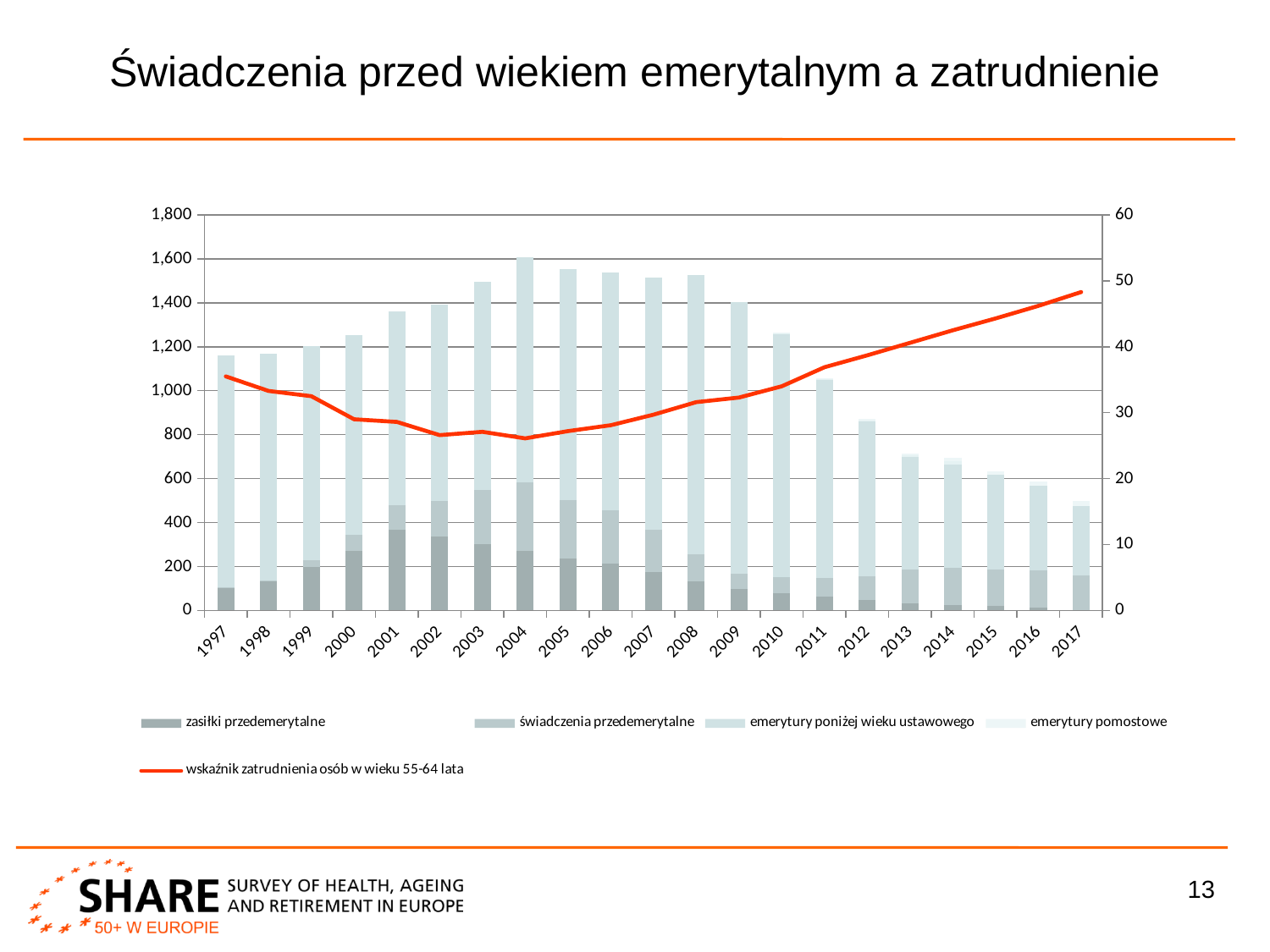
Which stacked bar is taller, 1997 or 2017? 1997 What kind of chart is shown on the slide? A stacked bar chart combined with a line How many years are shown along the x axis of the chart? 21 What is the title of the slide? Świadczenia przed wiekiem emerytalnym a zatrudnienie How many series does the chart's legend list? 5 Which year has the shortest stacked bar? 2017 Is the value of the line 'wskaźnik zatrudnienia osób w wieku 55-64 lata' in 2004 greater or less than 30? less Is the total of the stacked bar for 2017 greater or less than 600? less Does the line 'wskaźnik zatrudnienia osób w wieku 55-64 lata' rise or fall between 2004 and 2017? rise Is the total of the stacked bar for 2004 greater or less than 1,400? greater Which year has the tallest stacked bar? 2004